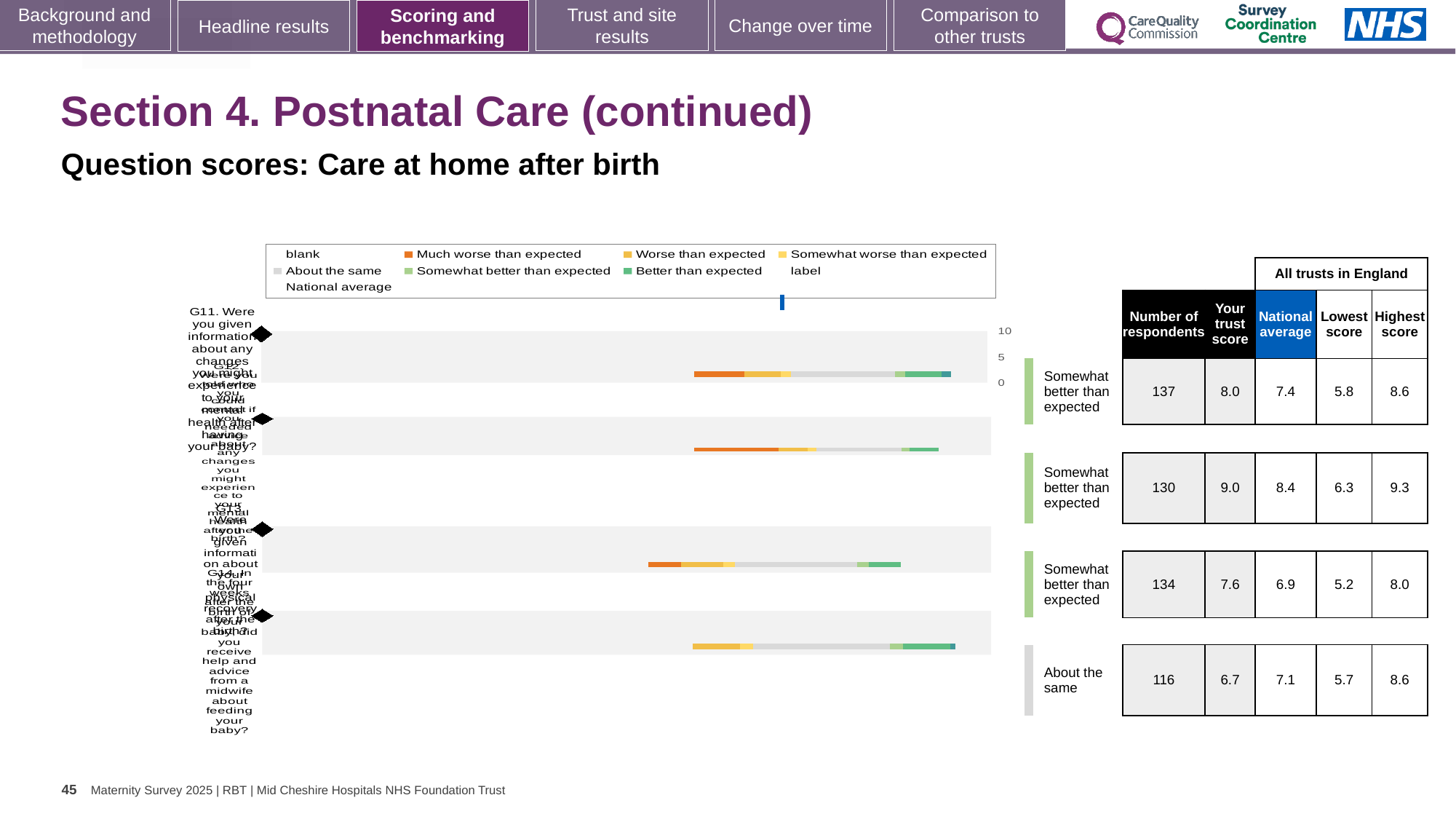
In the table beside the chart, which row has the lowest number of respondents? the bottom row (116) What is the highest value shown on the chart's score axis? 10 What colour does the legend use for "Much worse than expected"? orange In the table beside the chart, which row has the highest trust score? the second row (9.0) What kind of chart is shown on the slide? bar chart How many question rows (bars) does the chart show? 4 In the table beside the chart, is the trust score or the national average larger for the first row (G11)? trust score In the table beside the chart, what is the number of respondents for the first row (G11)? 137 In the table beside the chart, what is the difference between the trust score and the national average for the first row (G11)? 0.6 In the table beside the chart, what is the national average for the first row (G11)? 7.4 What benchmark category is shown for the bottom row of the chart? About the same In the table beside the chart, what is the trust score for the first row (G11)? 8.0